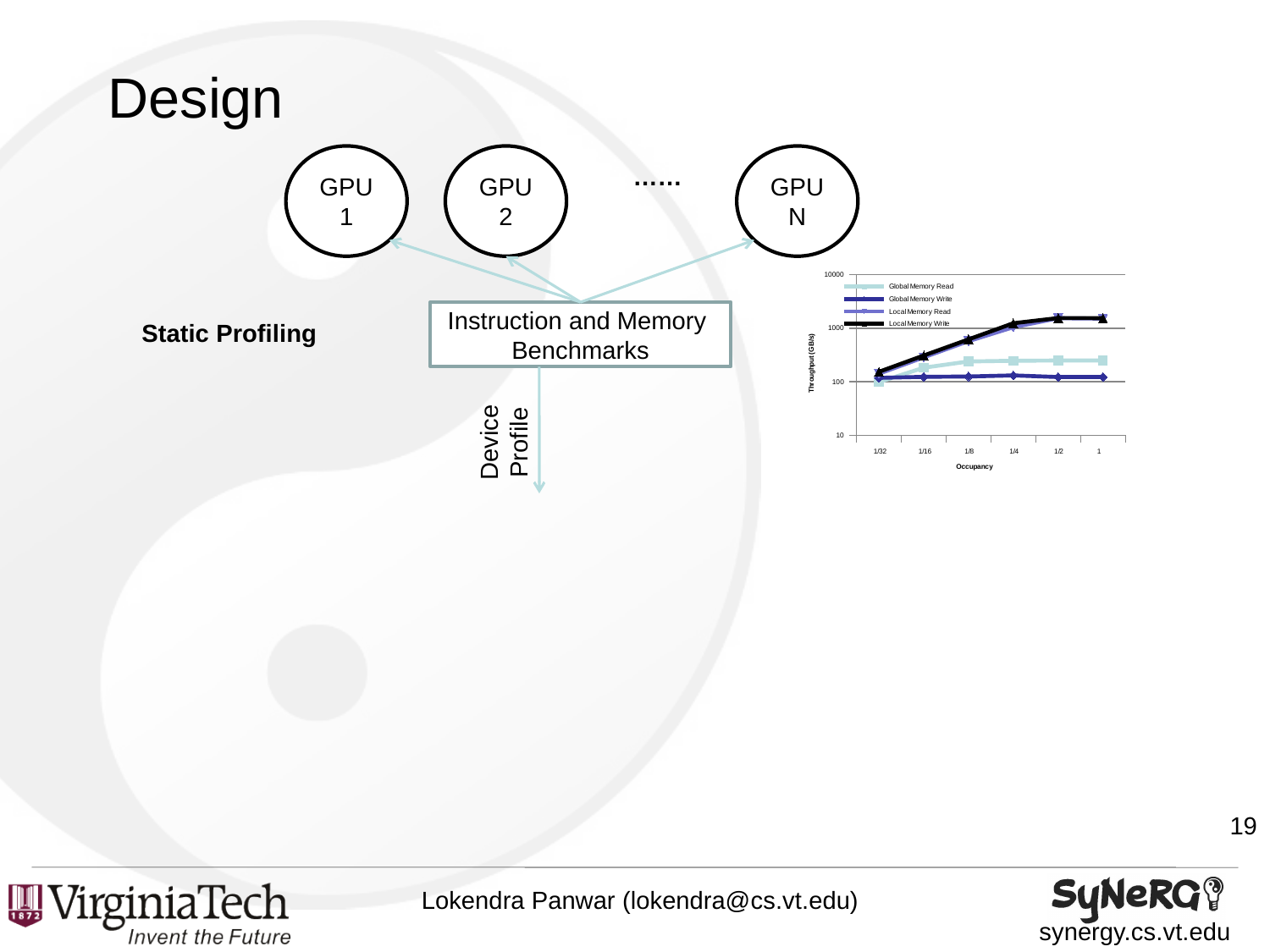
How many series does the chart's legend list? 4 Is the Local Memory Write throughput at occupancy 1 greater or less than 1000? greater Is the Global Memory Read throughput at occupancy 1/32 greater or less than 1000? less At occupancy 1, which is larger: Global Memory Read throughput or Global Memory Write throughput? Global Memory Read At occupancy 1, which is larger: Local Memory Write throughput or Global Memory Write throughput? Local Memory Write How many occupancy values are plotted along the x axis of the chart? 6 What is the label of the x axis of the chart? Occupancy Does the Local Memory Write throughput rise or fall as occupancy increases from 1/32 to 1? rise What kind of chart is shown on the slide? line chart Which series has the lowest throughput at occupancy 1? Global Memory Write Is the Global Memory Write throughput at occupancy 1 greater or less than 1000? less What is the label of the y axis of the chart? Throughput (GB/s)